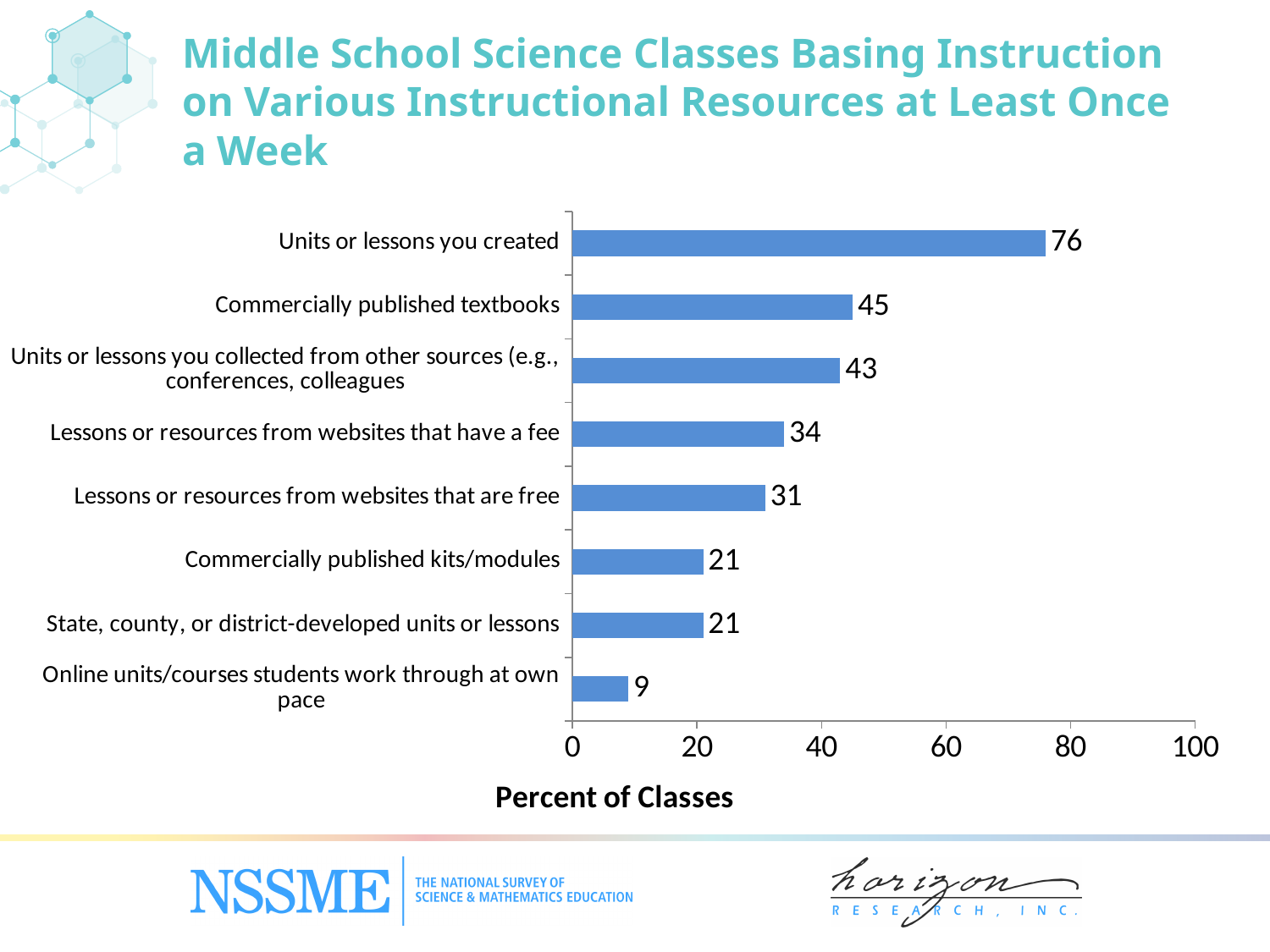
How many instructional resource categories are shown in the chart? 8 Which is larger: the value for lessons or resources from websites that have a fee or the value for lessons or resources from websites that are free? Lessons or resources from websites that have a fee What is the value for commercially published textbooks? 45 What is the label of the horizontal axis? Percent of Classes What is the value for lessons or resources from websites that are free? 31 Is the value for commercially published kits/modules greater or less than 40? less What is the difference between the values for units or lessons you created and commercially published textbooks? 31 What is the value for units or lessons you collected from other sources? 43 What kind of chart is shown on the slide? Bar chart What percent of classes base instruction on units or lessons the teacher created at least once a week? 76 Which instructional resource has the highest percent of classes? Units or lessons you created Which instructional resource has the lowest percent of classes? Online units/courses students work through at own pace